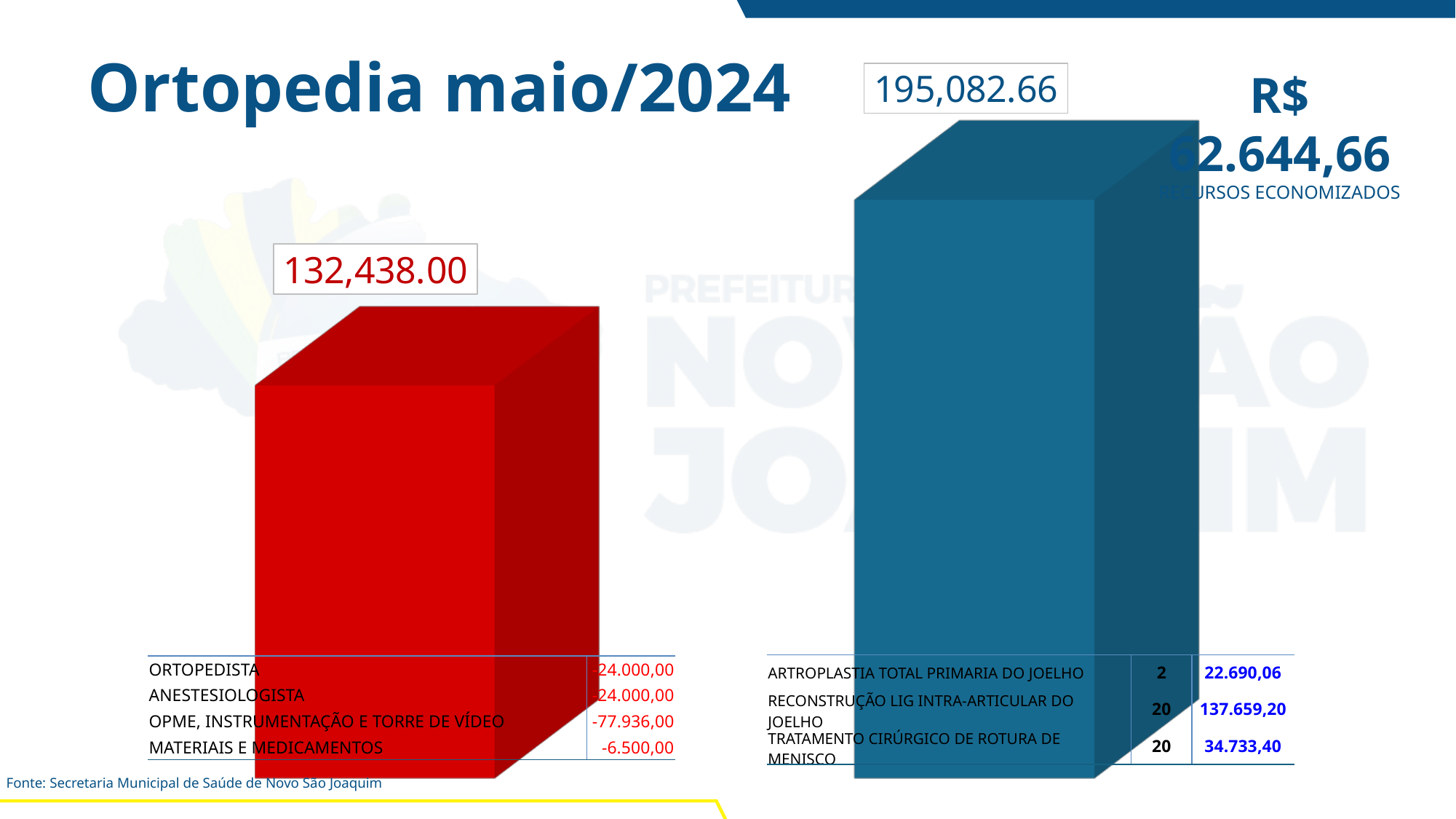
What value is labelled on the blue bar on the right? 195,082.66 How many bars does the chart show? 2 Is the value of the blue bar larger or smaller than the value of the red bar? larger Which bar has the higher value, the red bar or the blue bar? the blue bar What is the difference between the blue bar's value (195,082.66) and the red bar's value (132,438.00)? 62,644.66 What is the title of the slide containing the chart? Ortopedia maio/2024 What colour is the bar on the left of the chart? red Which bar has the lower value, the red bar or the blue bar? the red bar What kind of chart is shown on the slide? bar chart What value is labelled on the red bar on the left? 132,438.00